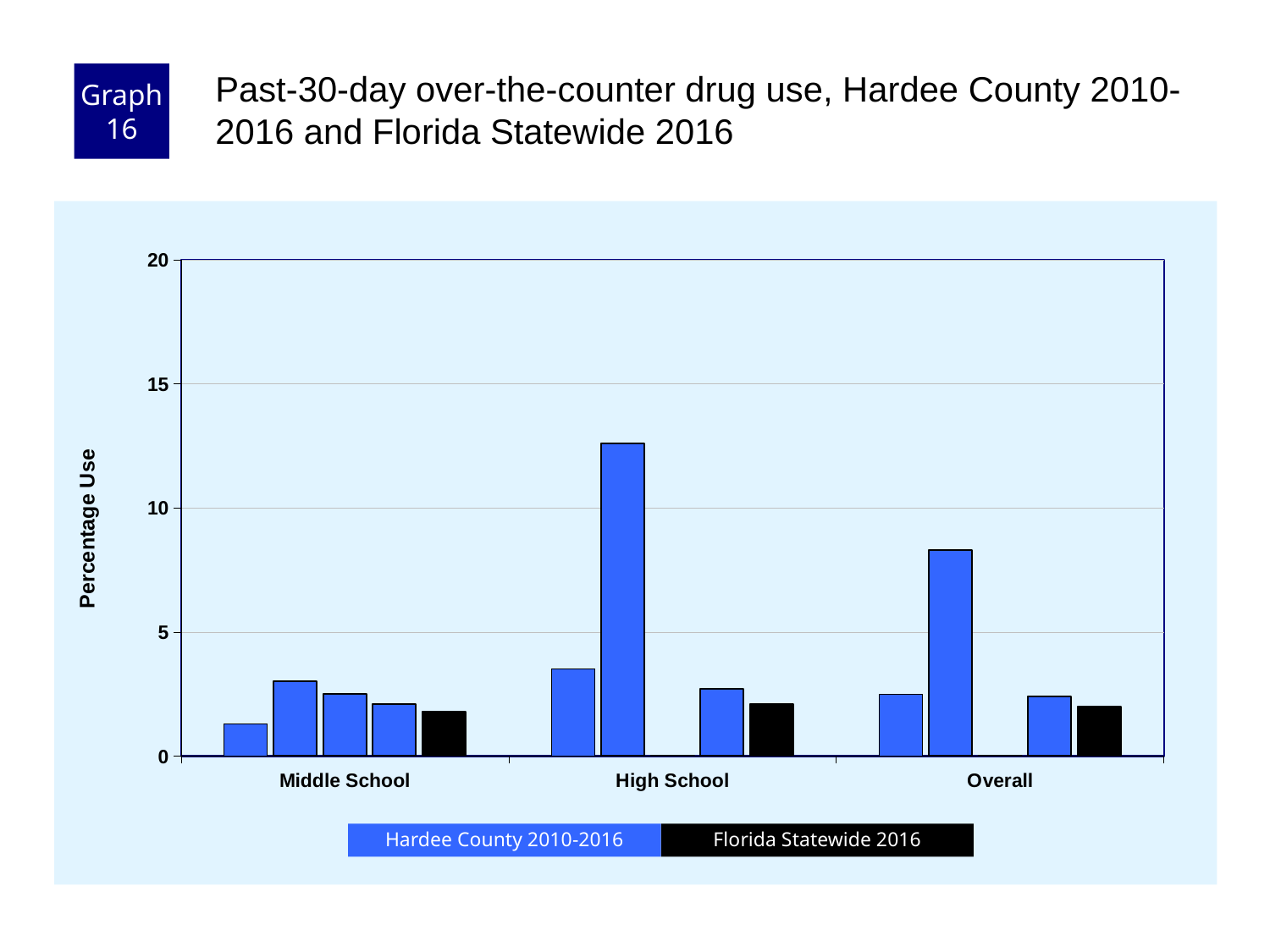
Which is larger: the tallest Hardee County 2010-2016 bar for High School or the tallest Hardee County 2010-2016 bar for Overall? High School Which series is shown in black in the chart legend? Florida Statewide 2016 What kind of chart is shown on the slide? bar chart Are all Hardee County 2010-2016 bars for Middle School greater or less than 5? less Which category contains the tallest bar in the chart? High School Is the tallest Hardee County 2010-2016 bar for Overall greater or less than 5? greater Is the tallest Hardee County 2010-2016 bar for High School greater or less than 10? greater What is the label on the vertical axis of the chart? Percentage Use How many series does the chart legend list? 2 How many categories are shown on the x axis of the chart? 3